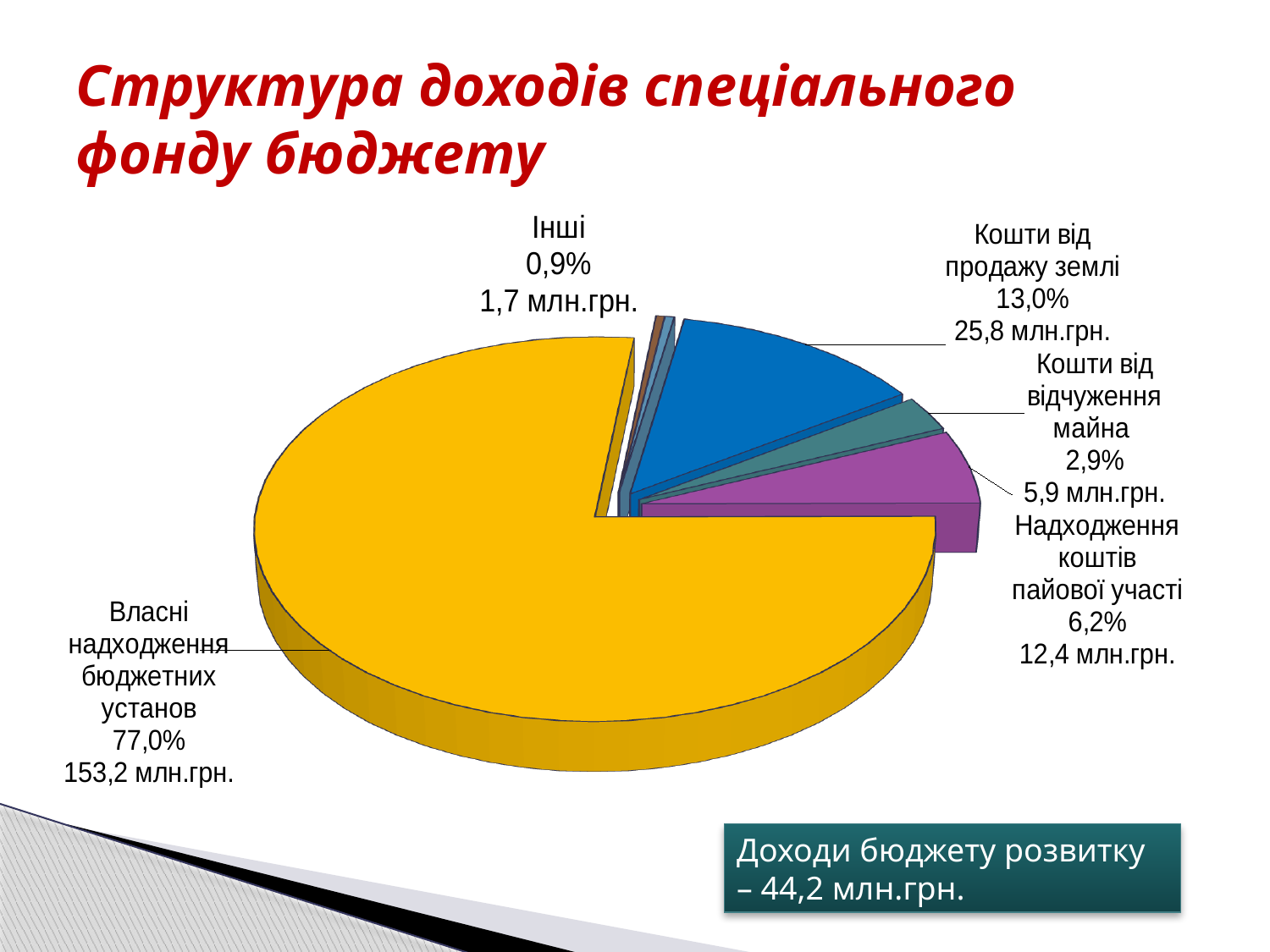
What kind of chart is shown on the slide? pie chart What is the value in млн.грн. for "Надходження коштів пайової участі"? 12,4 млн.грн. What share of the pie does "Кошти від відчуження майна" have? 2,9% What is the title of the slide containing the chart? Структура доходів спеціального фонду бюджету What is the difference in percentage points between the shares of "Надходження коштів пайової участі" and "Кошти від відчуження майна"? 3,3 What is the value in млн.грн. for "Кошти від продажу землі"? 25,8 млн.грн. Which category has the smallest slice of the pie? Інші Which is larger: "Кошти від продажу землі" or "Надходження коштів пайової участі"? Кошти від продажу землі What is the difference in млн.грн. between "Кошти від продажу землі" and "Кошти від відчуження майна"? 19,9 млн.грн. What share of the pie does "Власні надходження бюджетних установ" have? 77,0% Which category has the largest slice of the pie? Власні надходження бюджетних установ What share of the pie does "Інші" have? 0,9%